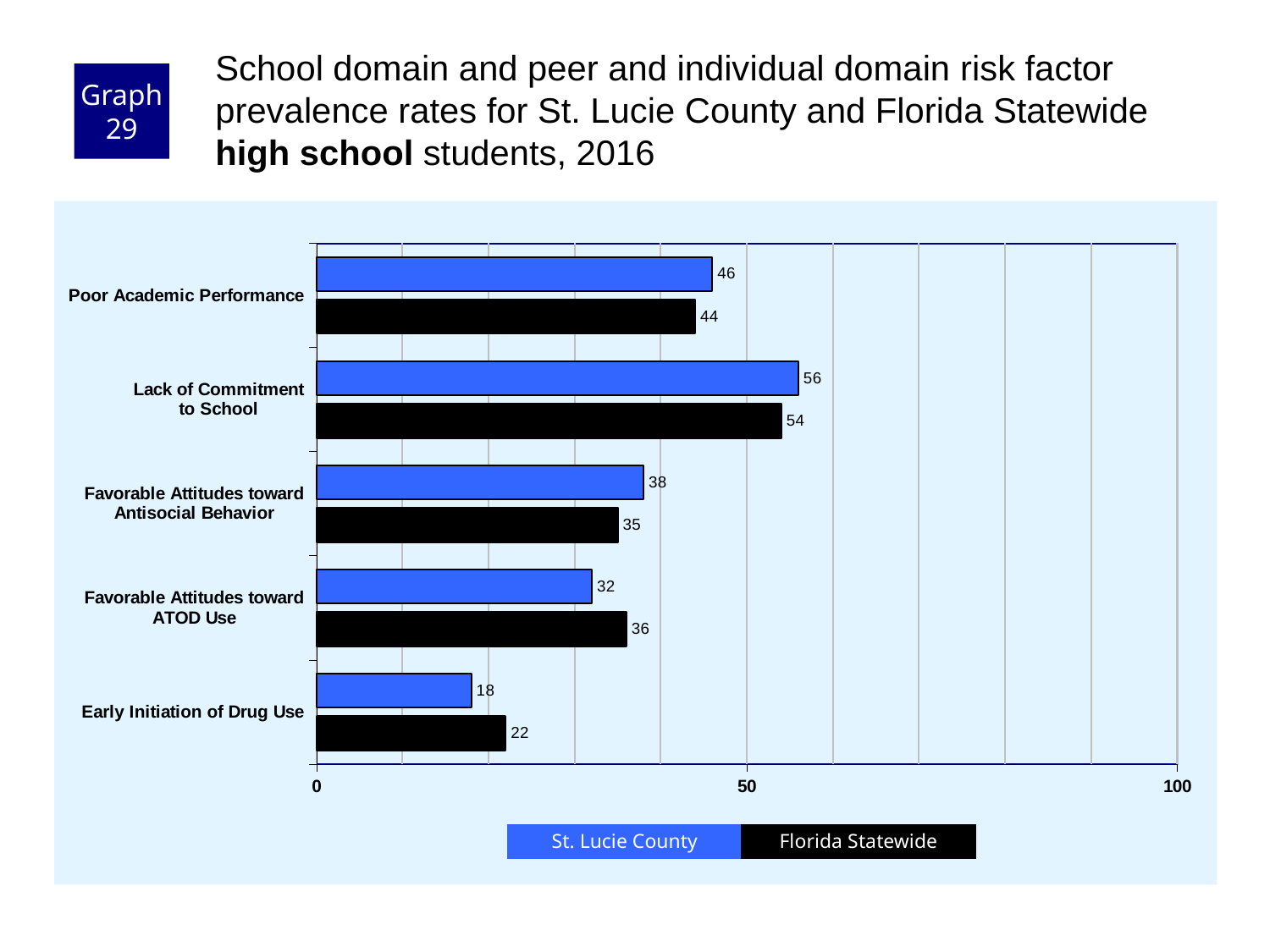
Which risk factor has the highest St. Lucie County value? Lack of Commitment to School What is the difference between the St. Lucie County and Florida Statewide values for Favorable Attitudes toward Antisocial Behavior? 3 Which risk factor has the lowest Florida Statewide value? Early Initiation of Drug Use Is the St. Lucie County value for Poor Academic Performance greater or less than 50? less What kind of chart is shown on the slide? bar chart What is the Florida Statewide value for Favorable Attitudes toward ATOD Use? 36 How many series does the legend list? 2 Which colour represents Florida Statewide in the chart? black For Favorable Attitudes toward ATOD Use, which is larger: the St. Lucie County value or the Florida Statewide value? Florida Statewide What is the Florida Statewide value for Early Initiation of Drug Use? 22 How many risk factors are shown on the chart? 5 What is the St. Lucie County value for Lack of Commitment to School? 56